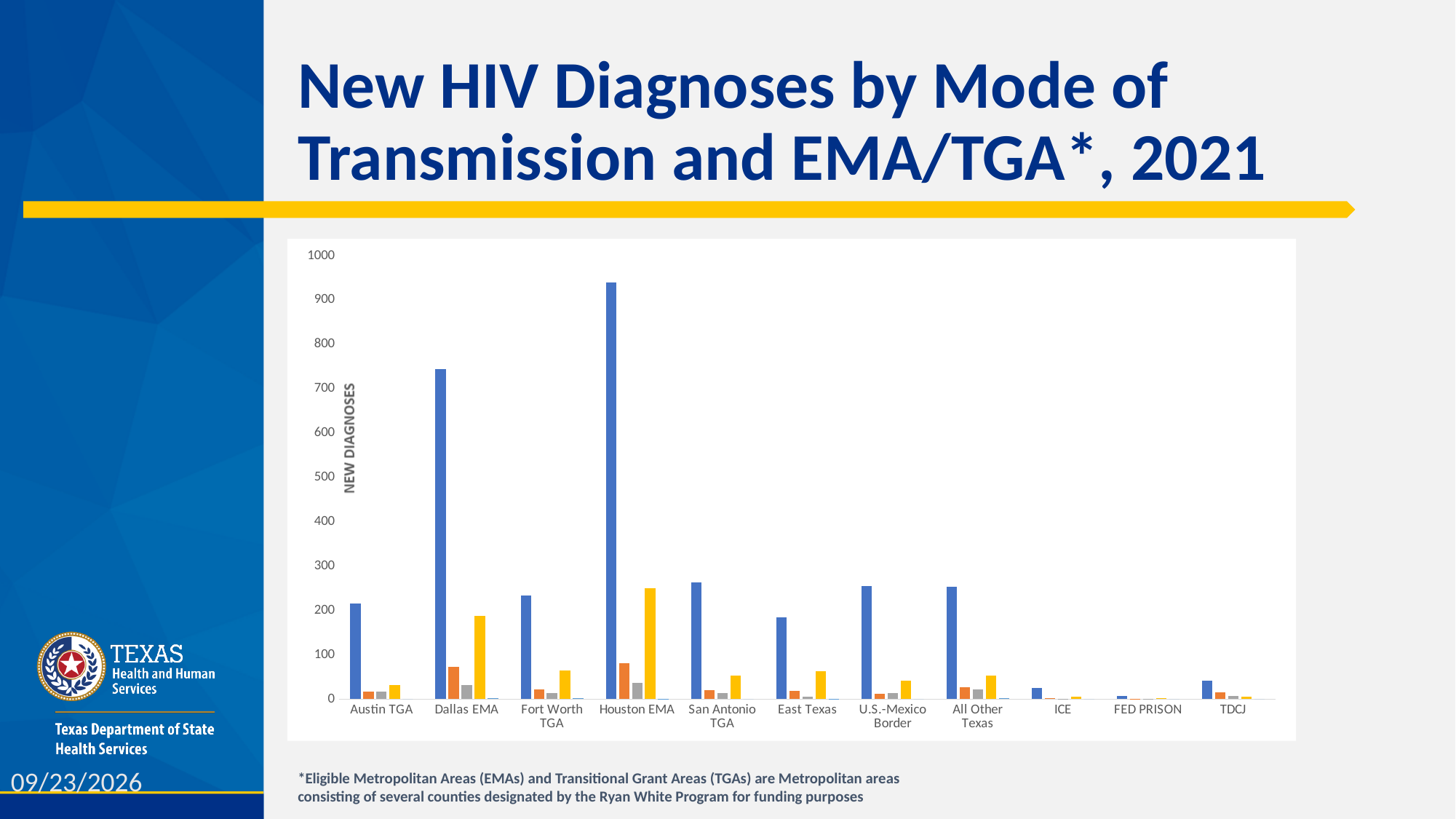
Is the yellow bar for Houston EMA greater or less than 200? greater Is the blue bar for Dallas EMA greater or less than 700? greater Is the blue bar for Austin TGA greater or less than 200? greater What is the title of the slide containing the chart? New HIV Diagnoses by Mode of Transmission and EMA/TGA*, 2021 What kind of chart is shown on the slide? bar chart What is the label on the vertical axis of the chart? NEW DIAGNOSES Which is larger, the blue bar for San Antonio TGA or the blue bar for East Texas? San Antonio TGA Which category has the tallest blue bar? Houston EMA Which is larger, the blue bar for Dallas EMA or the blue bar for Fort Worth TGA? Dallas EMA How many categories are shown along the x axis of the chart? 11